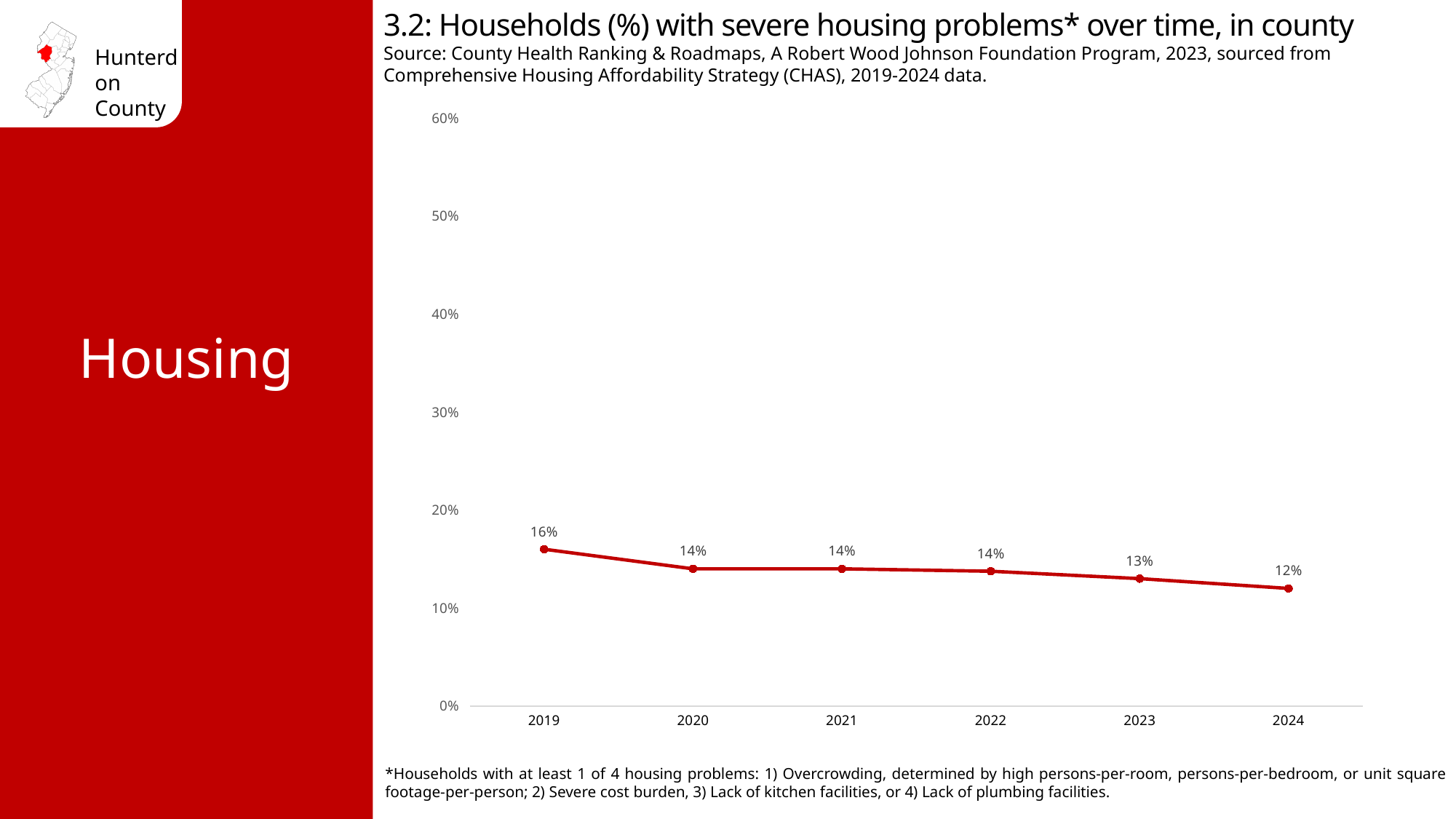
What is the difference between the 2019 value and the 2024 value? 4% Which year has the highest percentage of households with severe housing problems? 2019 What kind of chart is shown on the slide? line chart Do the values rise or fall from 2019 to 2024? fall Which is larger, the value for 2020 or the value for 2023? 2020 How many years are plotted on the chart? 6 Which year has the lowest percentage of households with severe housing problems? 2024 What is the value shown for 2023? 13% Is the value for 2019 greater or less than 20%? less What is the value shown for 2024? 12% What is the value shown for 2021? 14% What percentage of households had severe housing problems in 2019? 16%